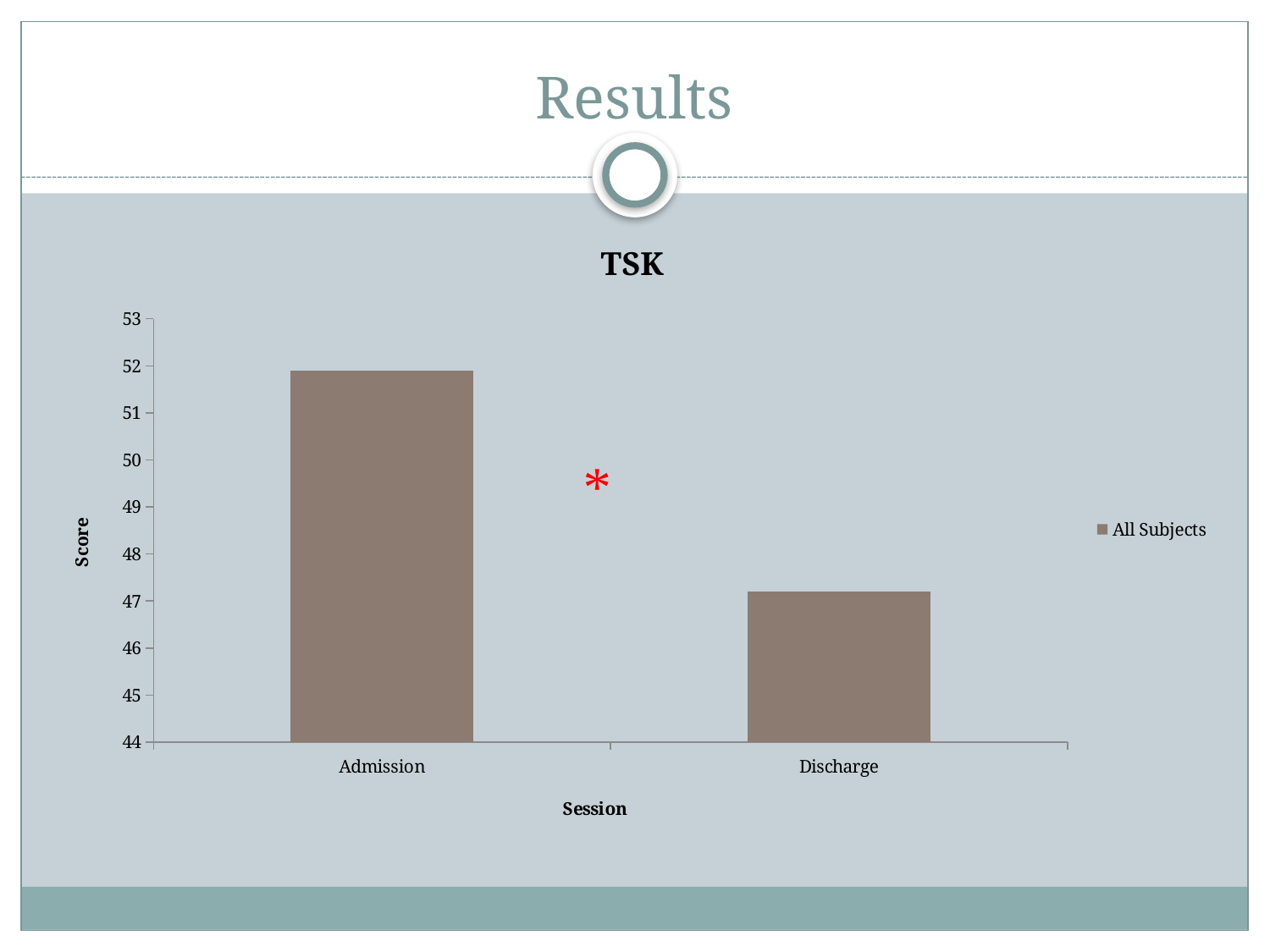
What is the title of the chart? TSK Which session has the lowest score? Discharge What series name appears in the legend? All Subjects Which is larger, the score at Admission or at Discharge? Admission Which session has the highest score? Admission How many series does the legend list? 1 How many categories are shown on the x axis? 2 Is the score for Discharge greater or less than 48? less What type of chart is shown on the slide? bar chart Do the scores rise or fall from Admission to Discharge? fall Is the score for Admission greater or less than 51? greater